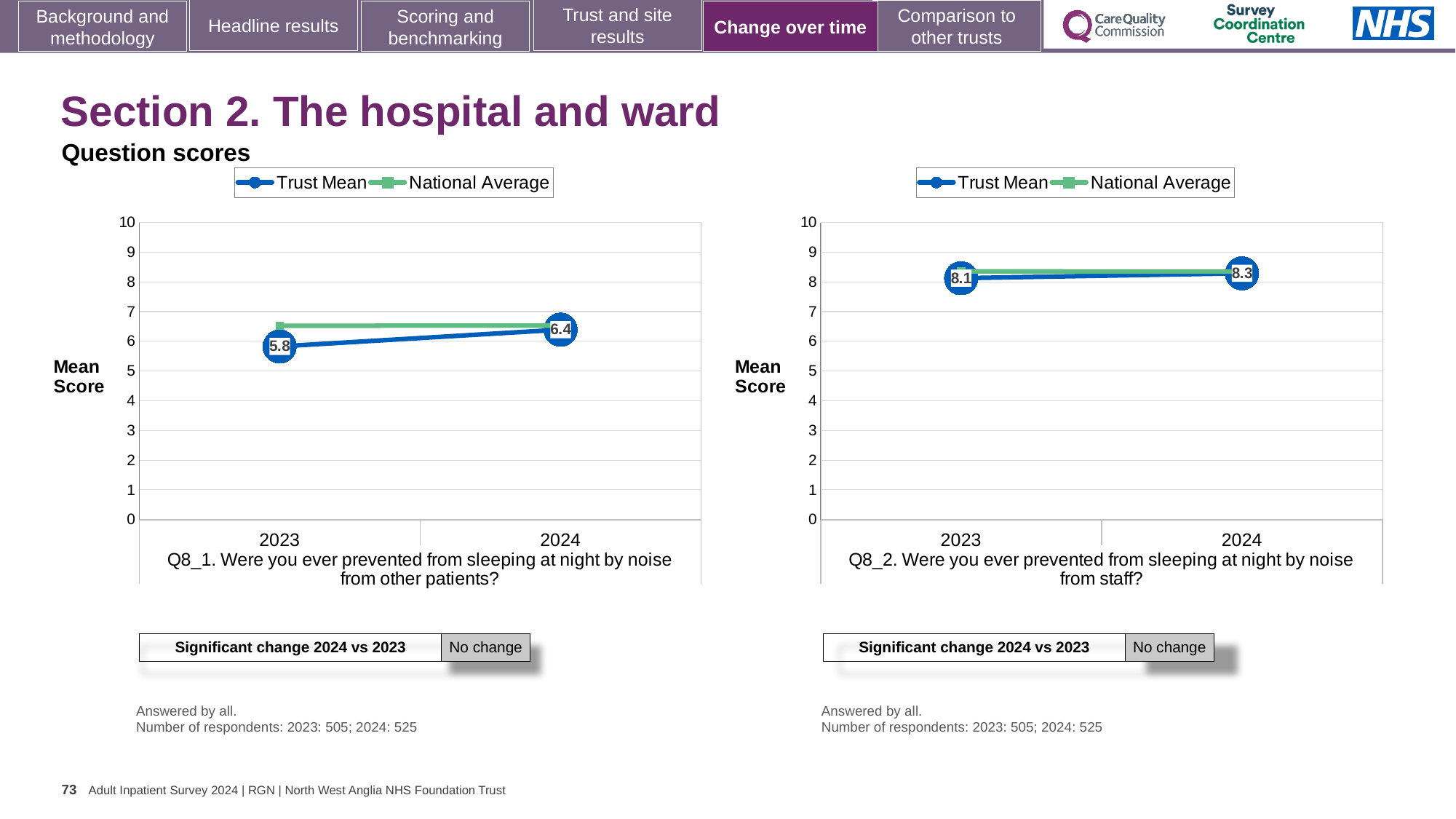
In the Q8_2 chart (right), what is the difference between the Trust Mean for 2024 and 2023? 0.2 What type of chart is the Q8_2 chart (right)? line chart In the Q8_1 chart (left), what is the Trust Mean for 2023? 5.8 In the Q8_2 chart (right), what is the Trust Mean for 2024? 8.3 In the Q8_2 chart (right), what is the Trust Mean for 2023? 8.1 How many series does the legend of the Q8_1 chart (left) list? 2 In the Q8_1 chart (left), what is the Trust Mean for 2024? 6.4 In the Q8_1 chart (left), is the Trust Mean for 2023 higher or lower than the National Average for 2023? lower In the Q8_2 chart (right), is the National Average for 2024 greater or less than 7? greater Which is larger: the 2024 Trust Mean in the Q8_1 chart (left) or the 2024 Trust Mean in the Q8_2 chart (right)? Q8_2 chart (right) In the Q8_1 chart (left), by how much did the Trust Mean change from 2023 to 2024? 0.6 In the Q8_1 chart (left), does the Trust Mean rise or fall from 2023 to 2024? rise